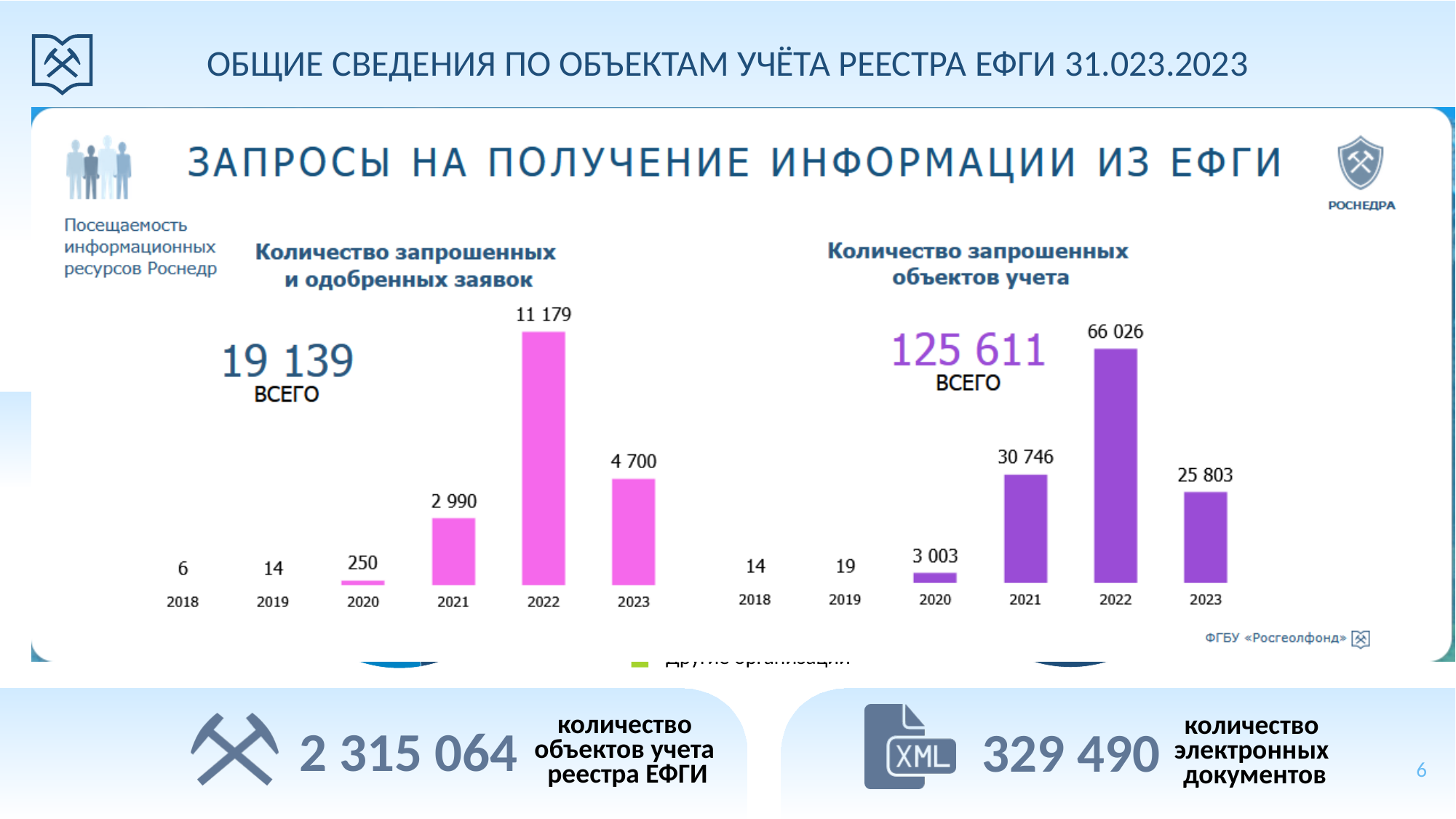
In the right chart (Количество запрошенных объектов учета), what is the value for 2021? 30 746 In the right chart (Количество запрошенных объектов учета), which year has the lowest value? 2018 In the left chart (Количество запрошенных и одобренных заявок), what is the value for 2022? 11 179 In the right chart (Количество запрошенных объектов учета), which is larger: the value for 2021 or the value for 2023? 2021 What type of chart is the right chart (Количество запрошенных объектов учета)? Bar chart What total (ВСЕГО) is printed on the right chart (Количество запрошенных объектов учета)? 125 611 In the left chart (Количество запрошенных и одобренных заявок), what is the difference between the values for 2022 and 2023? 6 479 How many years are shown on the x axis of the left chart (Количество запрошенных и одобренных заявок)? 6 In the right chart (Количество запрошенных объектов учета), what is the difference between the values for 2022 and 2021? 35 280 In the right chart (Количество запрошенных объектов учета), what is the value for 2023? 25 803 In the left chart (Количество запрошенных и одобренных заявок), what is the value for 2020? 250 In the left chart (Количество запрошенных и одобренных заявок), which year has the highest value? 2022